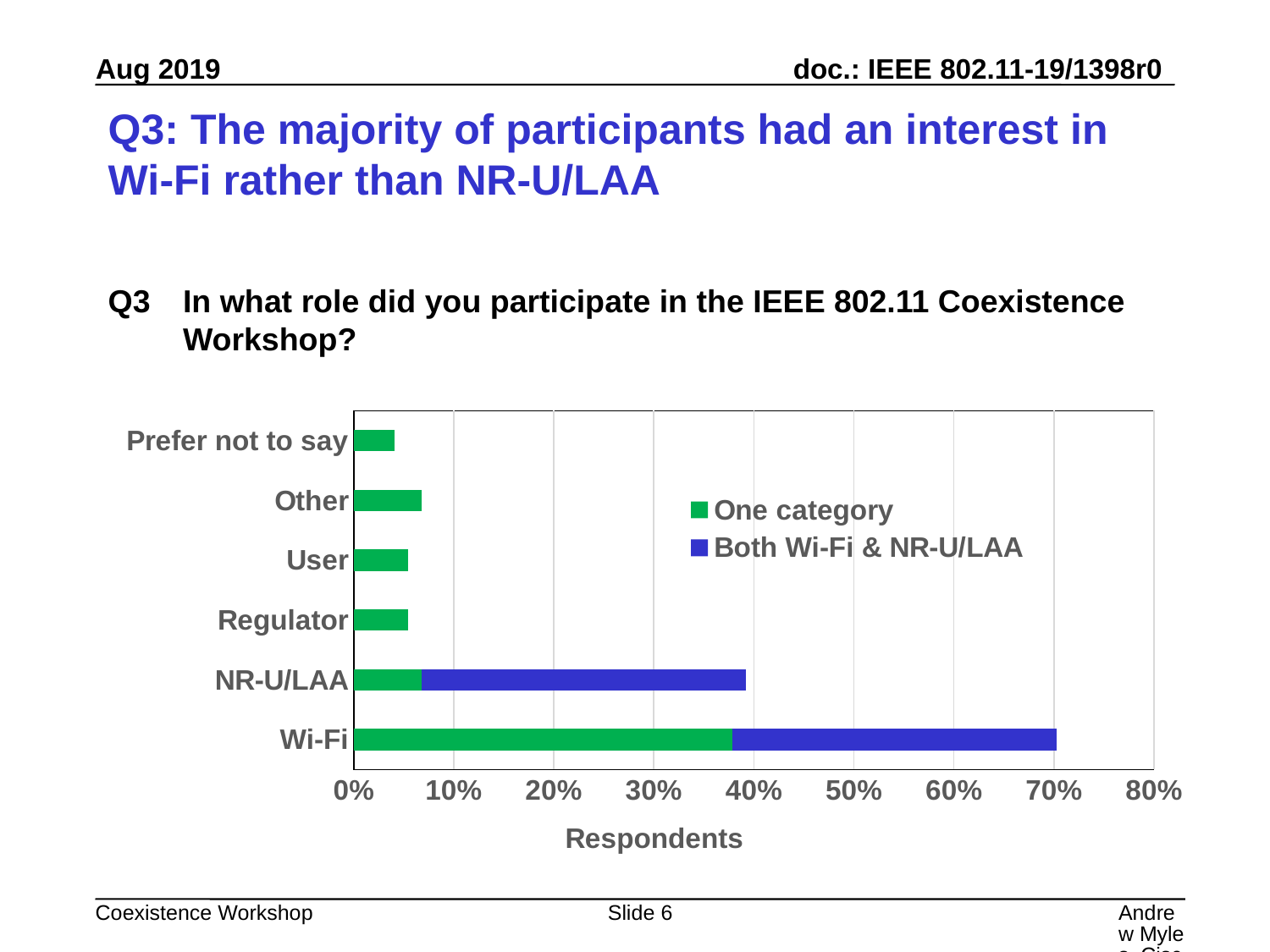
Which category has the longest bar overall? Wi-Fi How many categories are plotted on the chart? 6 Which category has the shortest bar? Prefer not to say Is the total value for NR-U/LAA greater or less than 50%? less Is the value for Prefer not to say greater or less than 10%? less Is the 'One category' value for Wi-Fi greater or less than 30%? greater What is the title of the horizontal axis? Respondents How many series does the chart's legend list? 2 Which category has a longer total bar, Wi-Fi or NR-U/LAA? Wi-Fi Which series is shown in blue in the legend? Both Wi-Fi & NR-U/LAA What kind of chart is shown on the slide? bar chart